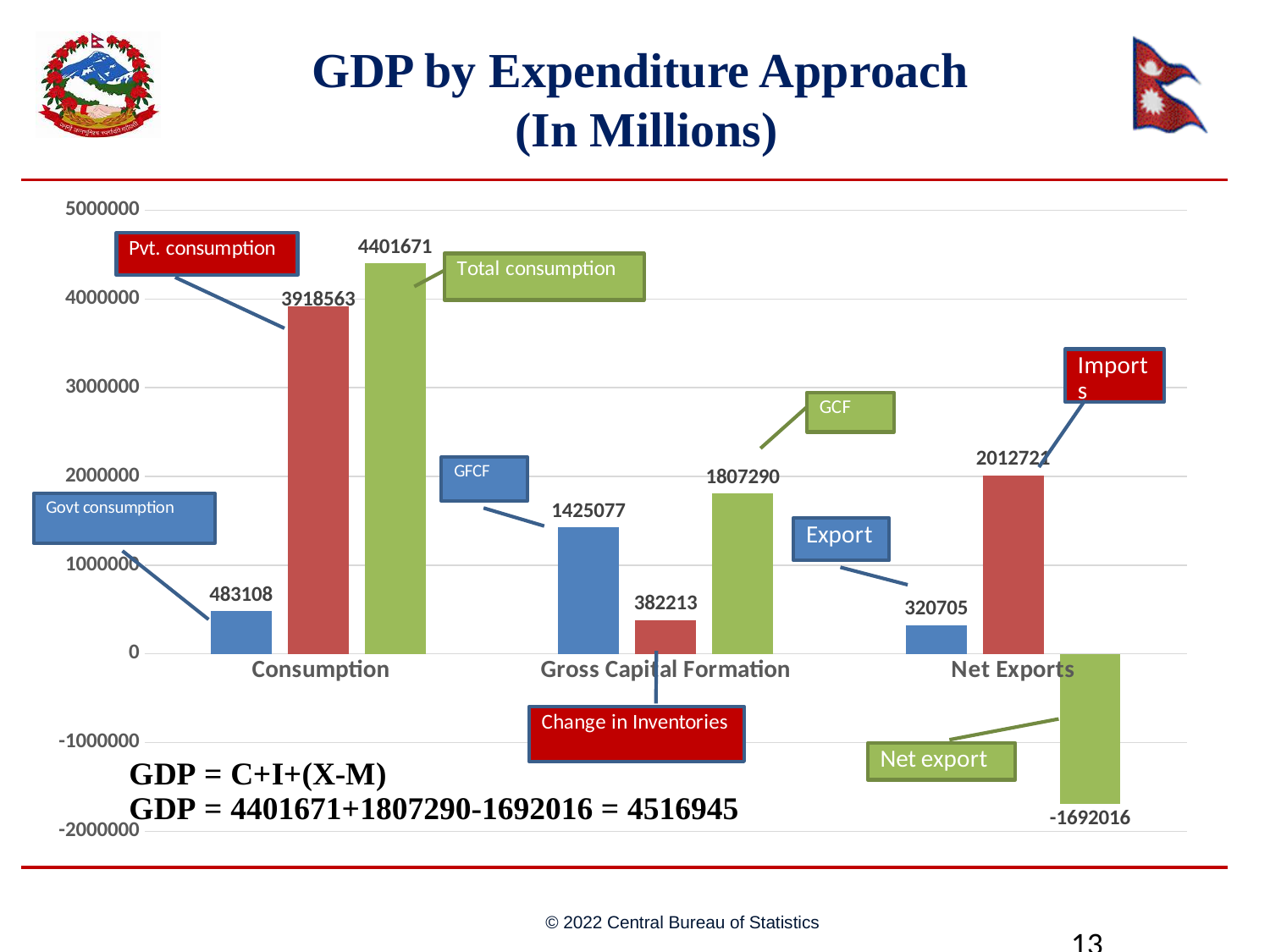
What is the value of the Govt consumption bar? 483108 What is the value of the Pvt. consumption bar? 3918563 Which bar on the chart has the highest value? Total consumption (4401671) What is the value of the GFCF bar in the Gross Capital Formation category? 1425077 What is the value of the Net export bar in the Net Exports category? -1692016 Which bar on the chart has the lowest value? Net export (-1692016) What type of chart is shown on the slide? Bar chart What is the difference between the Imports bar and the Export bar? 1692016 What is the value of the Change in Inventories bar? 382213 What is the value of the Total consumption bar in the Consumption category? 4401671 Which is larger, the GFCF bar or the Change in Inventories bar? GFCF How many categories are shown on the x axis of the chart? 3